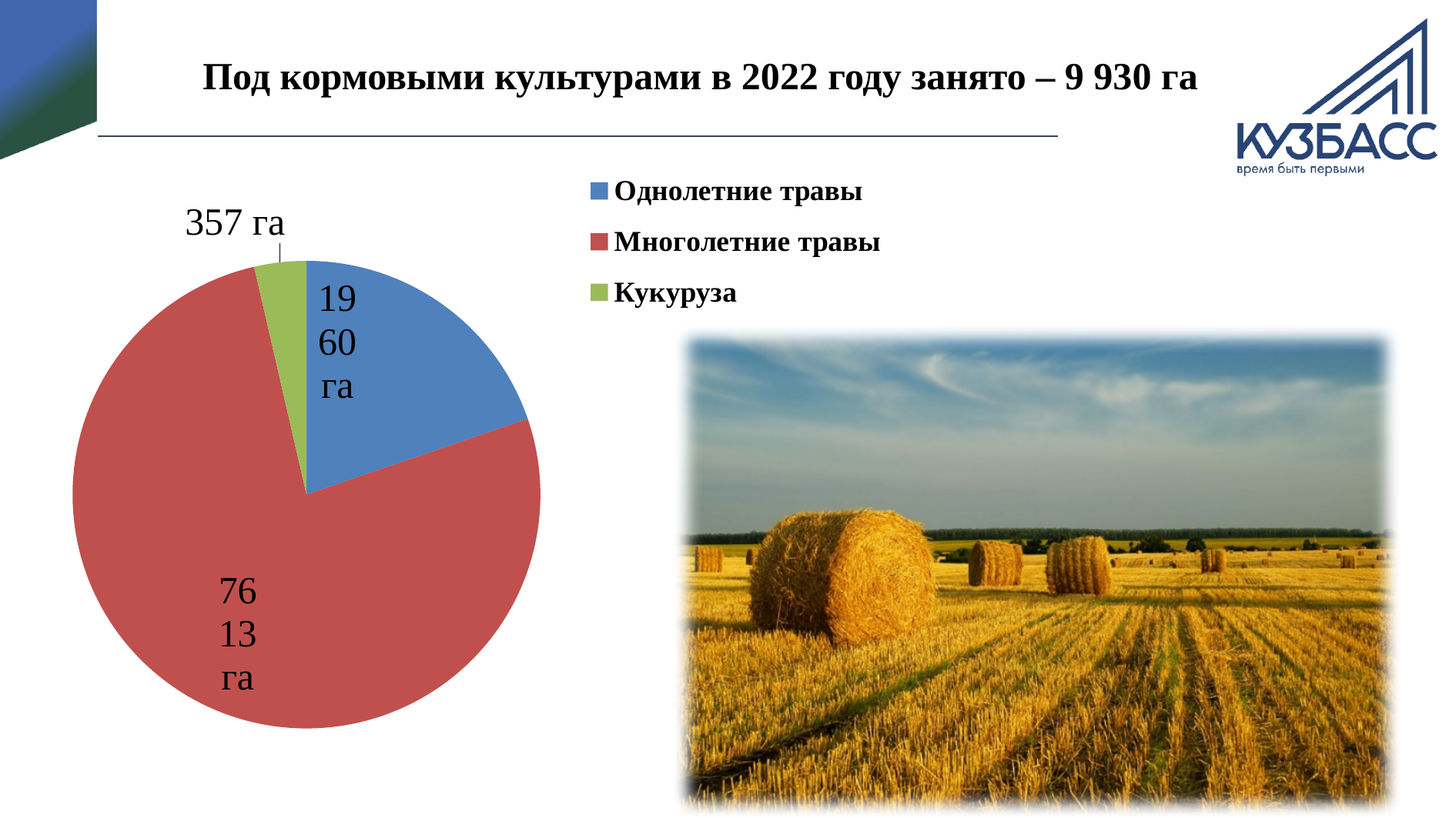
Which category has the smallest slice in the pie chart? Кукуруза How many slices does the pie chart have? 3 What is the value for Многолетние травы in the pie chart? 7613 га Which is larger in the pie chart: Однолетние травы or Кукуруза? Однолетние травы What colour is the slice for Многолетние травы? red Which category has the largest slice in the pie chart? Многолетние травы What total area under fodder crops in 2022 is stated in the slide title? 9 930 га How many entries does the legend of the pie chart list? 3 What is the value for Кукуруза in the pie chart? 357 га What is the value for Однолетние травы in the pie chart? 1960 га What is the difference between the values for Многолетние травы and Однолетние травы? 5653 га What kind of chart is shown on the slide? pie chart